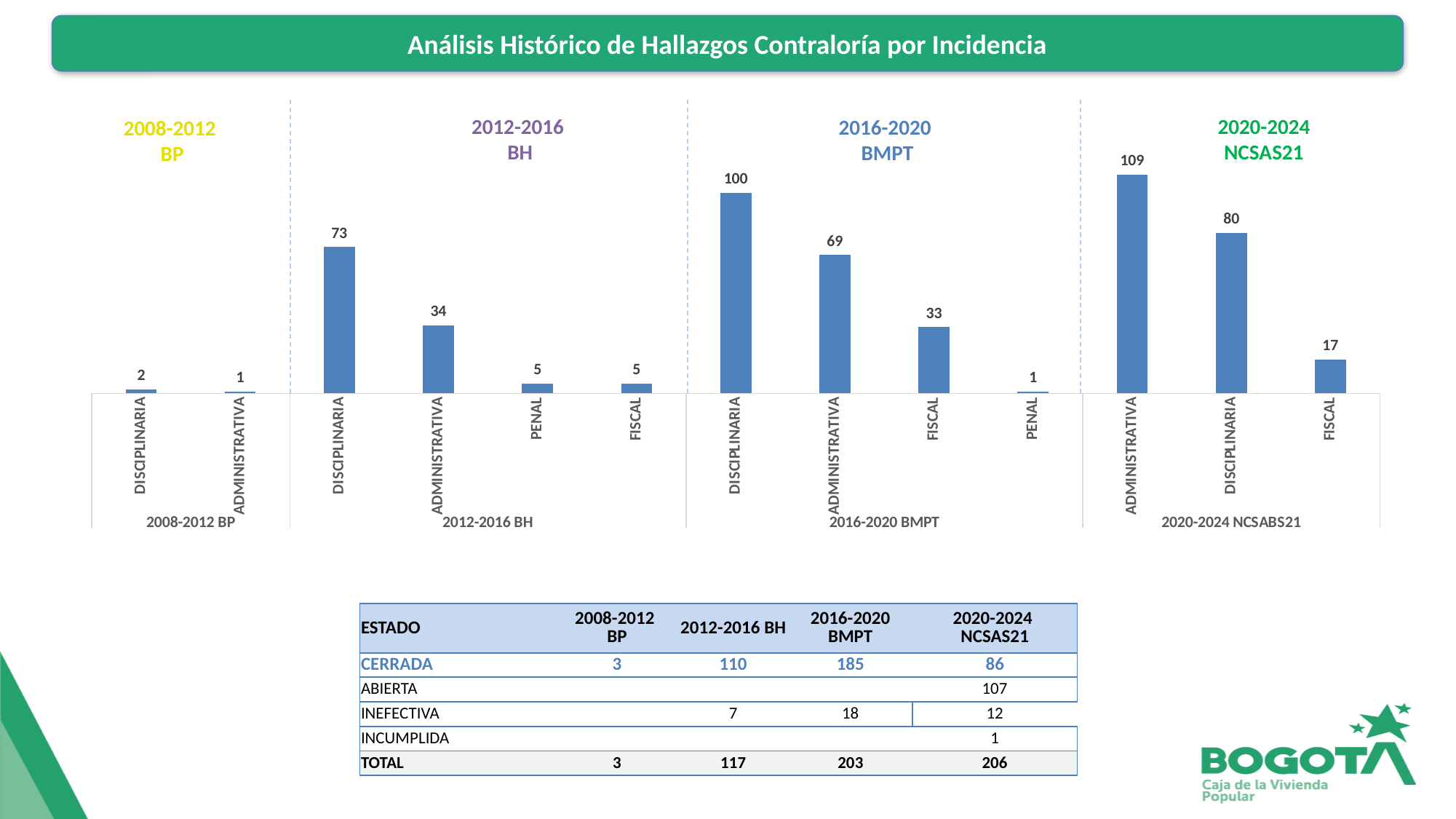
Which bar has the highest value in the whole chart? ADMINISTRATIVA (2020-2024 NCSAS21) How many bars are in the 2008-2012 BP group? 2 How many bars are plotted in the chart in total? 13 What is the value of the PENAL bar in the 2016-2020 BMPT group? 1 What is the difference between the DISCIPLINARIA and ADMINISTRATIVA bars in the 2012-2016 BH group? 39 Which is larger: DISCIPLINARIA in 2016-2020 BMPT or DISCIPLINARIA in 2020-2024 NCSAS21? DISCIPLINARIA in 2016-2020 BMPT What is the value of the ADMINISTRATIVA bar in the 2020-2024 NCSAS21 group? 109 What is the value of the FISCAL bar in the 2012-2016 BH group? 5 What is the value of the DISCIPLINARIA bar in the 2016-2020 BMPT group? 100 Which category has the lowest value in the 2012-2016 BH group? PENAL and FISCAL (both 5) What is the title shown above the chart? Análisis Histórico de Hallazgos Contraloría por Incidencia What type of chart is shown on the slide? Bar chart